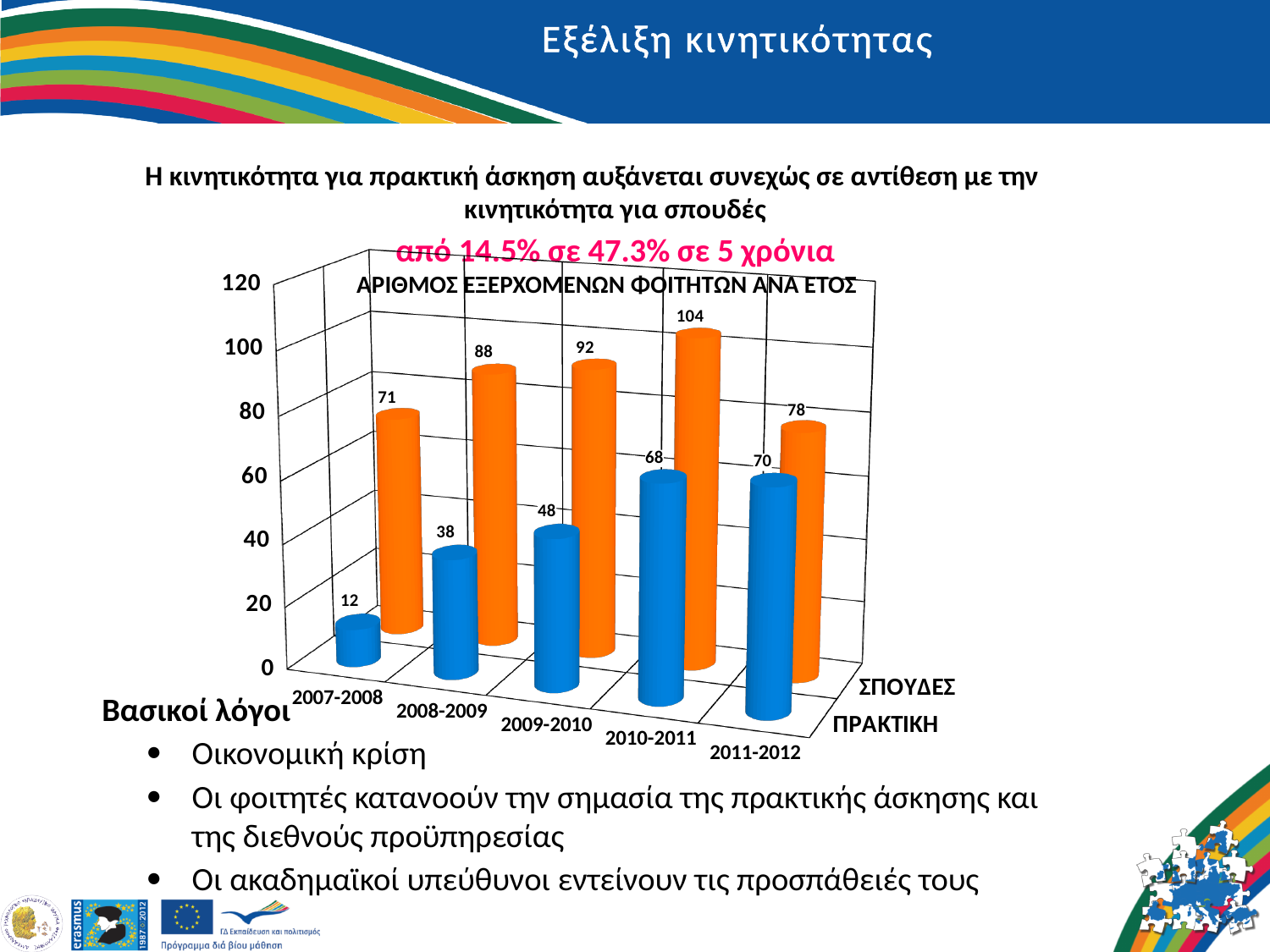
What is the title of the chart? ΑΡΙΘΜΟΣ ΕΞΕΡΧΟΜΕΝΩΝ ΦΟΙΤΗΤΩΝ ΑΝΑ ΕΤΟΣ What is the value for ΠΡΑΚΤΙΚΗ in 2009-2010? 48 What type of chart is shown on the slide? bar chart How many academic years are shown on the x axis? 5 In which year is the ΠΡΑΚΤΙΚΗ value lowest? 2007-2008 How many series does the chart show? 2 In which year is the ΣΠΟΥΔΕΣ value highest? 2010-2011 Do the ΠΡΑΚΤΙΚΗ values rise or fall from 2007-2008 to 2011-2012? rise What is the difference between ΣΠΟΥΔΕΣ and ΠΡΑΚΤΙΚΗ in 2011-2012? 8 Which is larger in 2008-2009, ΣΠΟΥΔΕΣ or ΠΡΑΚΤΙΚΗ? ΣΠΟΥΔΕΣ What is the value for ΠΡΑΚΤΙΚΗ in 2007-2008? 12 What is the value for ΣΠΟΥΔΕΣ in 2010-2011? 104